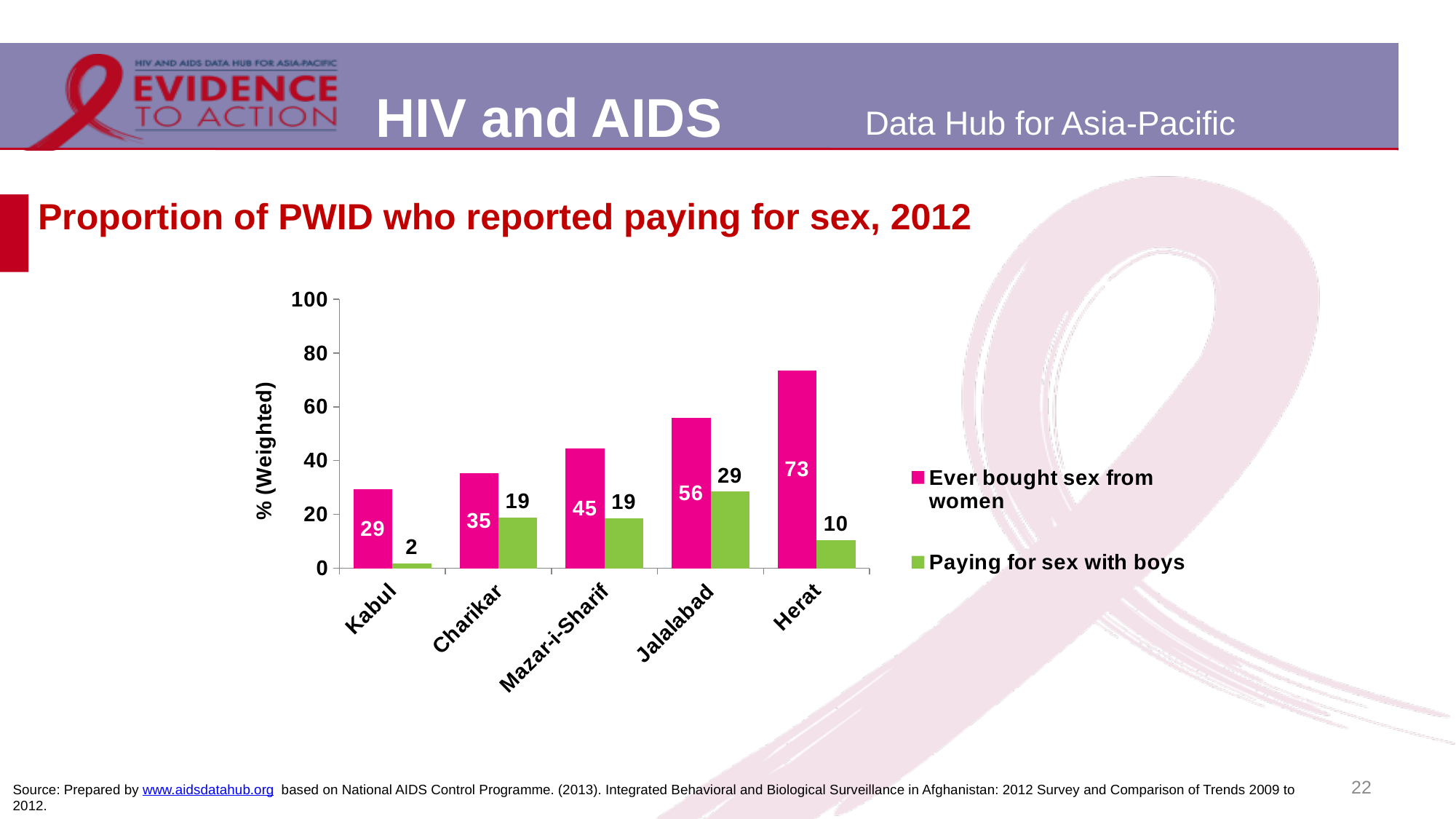
How many cities are shown on the x axis? 5 What kind of chart is shown on the slide? bar chart What is the value for 'Paying for sex with boys' in Kabul? 2 How many series does the legend list? 2 Do the values for 'Ever bought sex from women' rise or fall from Kabul to Herat? rise Which city has the highest value for 'Ever bought sex from women'? Herat What is the value for 'Ever bought sex from women' in Jalalabad? 56 Which is larger: 'Paying for sex with boys' in Jalalabad or in Herat? Jalalabad What is the value for 'Ever bought sex from women' in Herat? 73 What is the difference between 'Ever bought sex from women' and 'Paying for sex with boys' in Jalalabad? 27 Which city has the lowest value for 'Paying for sex with boys'? Kabul Is the value for 'Ever bought sex from women' in Mazar-i-Sharif greater or less than 40? greater